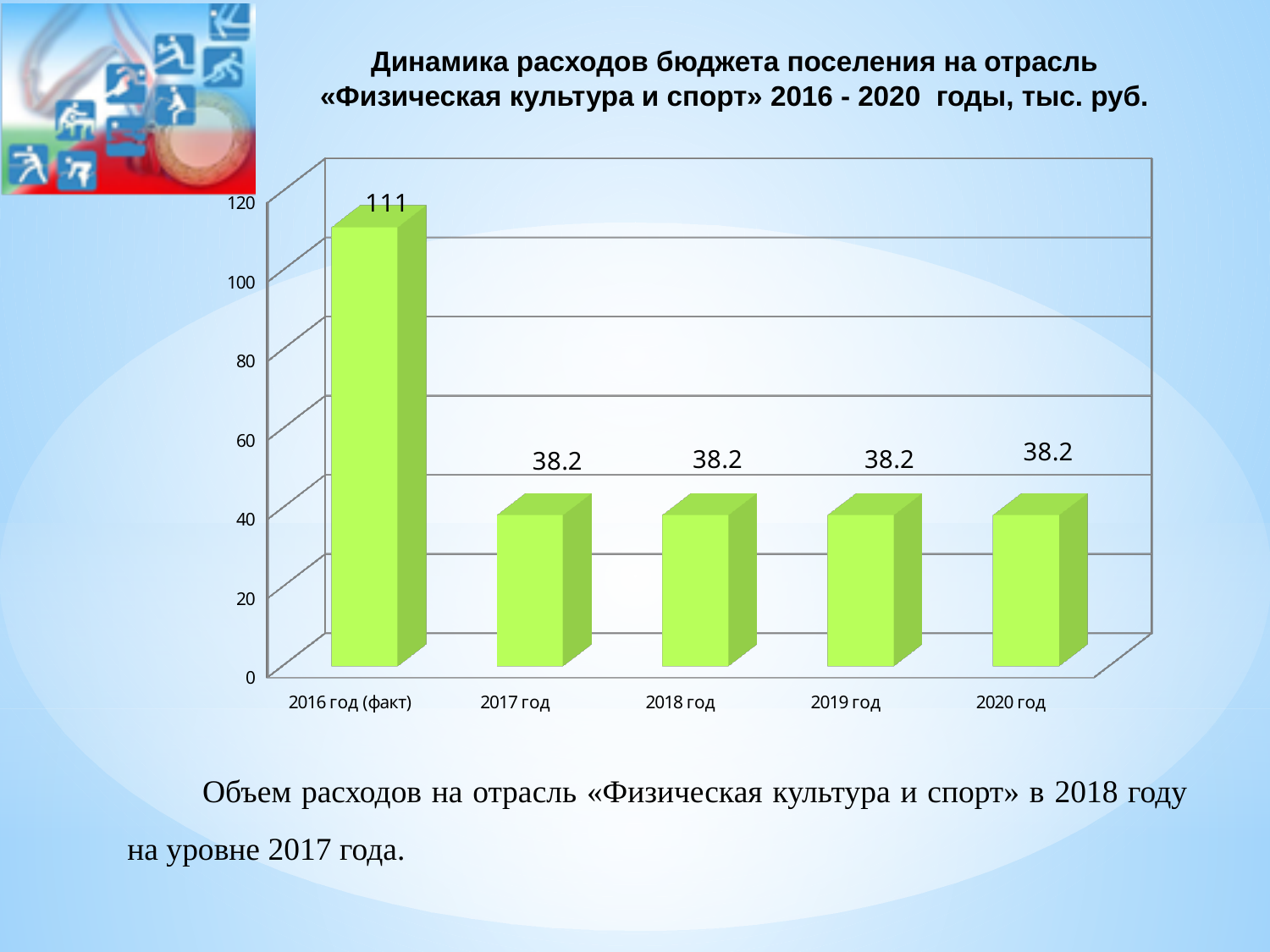
What kind of chart is shown on the slide? bar chart Which is larger, the value for 2016 год (факт) or the value for 2019 год? 2016 год (факт) What is the value for 2016 год (факт)? 111 What is the difference between the values for 2016 год (факт) and 2017 год? 72.8 Is the value for 2016 год (факт) greater or less than 100? greater How many categories are shown on the x axis? 5 What is the value for 2020 год? 38.2 Which category has the highest value? 2016 год (факт) Is the value for 2017 год greater or less than 40? less What is the highest tick value shown on the vertical axis? 120 What is the value for 2018 год? 38.2 Do the values rise or fall from 2016 год (факт) to 2017 год? fall